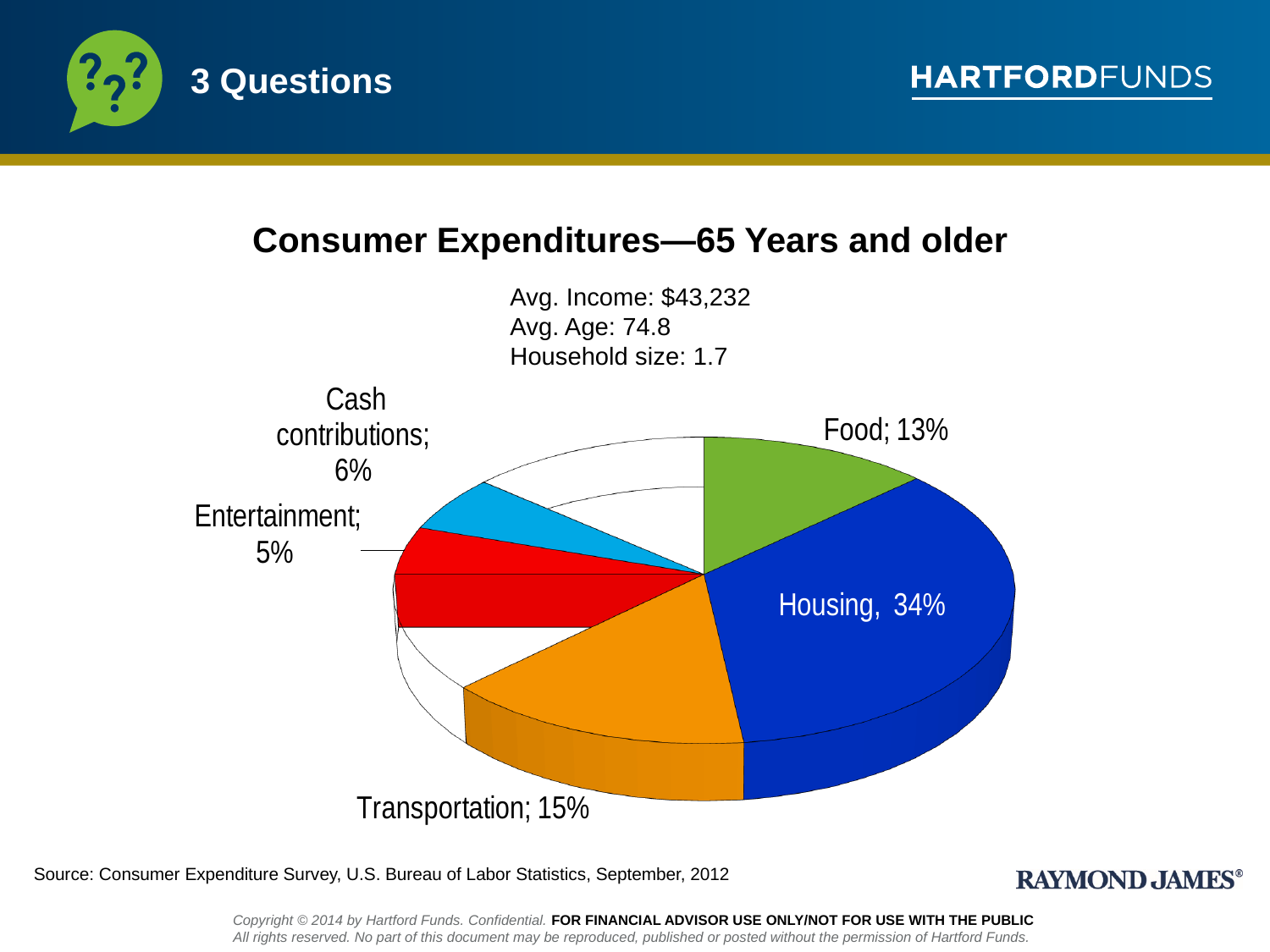
Which labeled category has the largest share of the pie? Housing What percentage is shown for Cash contributions? 6% Which labeled category has the smallest share of the pie? Entertainment What is the title of the chart? Consumer Expenditures—65 Years and older What kind of chart is shown on the slide? Pie chart What percentage of consumer expenditures goes to Housing? 34% What is the difference in percentage points between Transportation and Food? 2 How many percentage points larger is Housing than Food? 21 What percentage is shown for Entertainment? 5% What share of expenditures is labeled for Food? 13% Which is larger, the share for Cash contributions or the share for Entertainment? Cash contributions What percentage is shown for Transportation? 15%